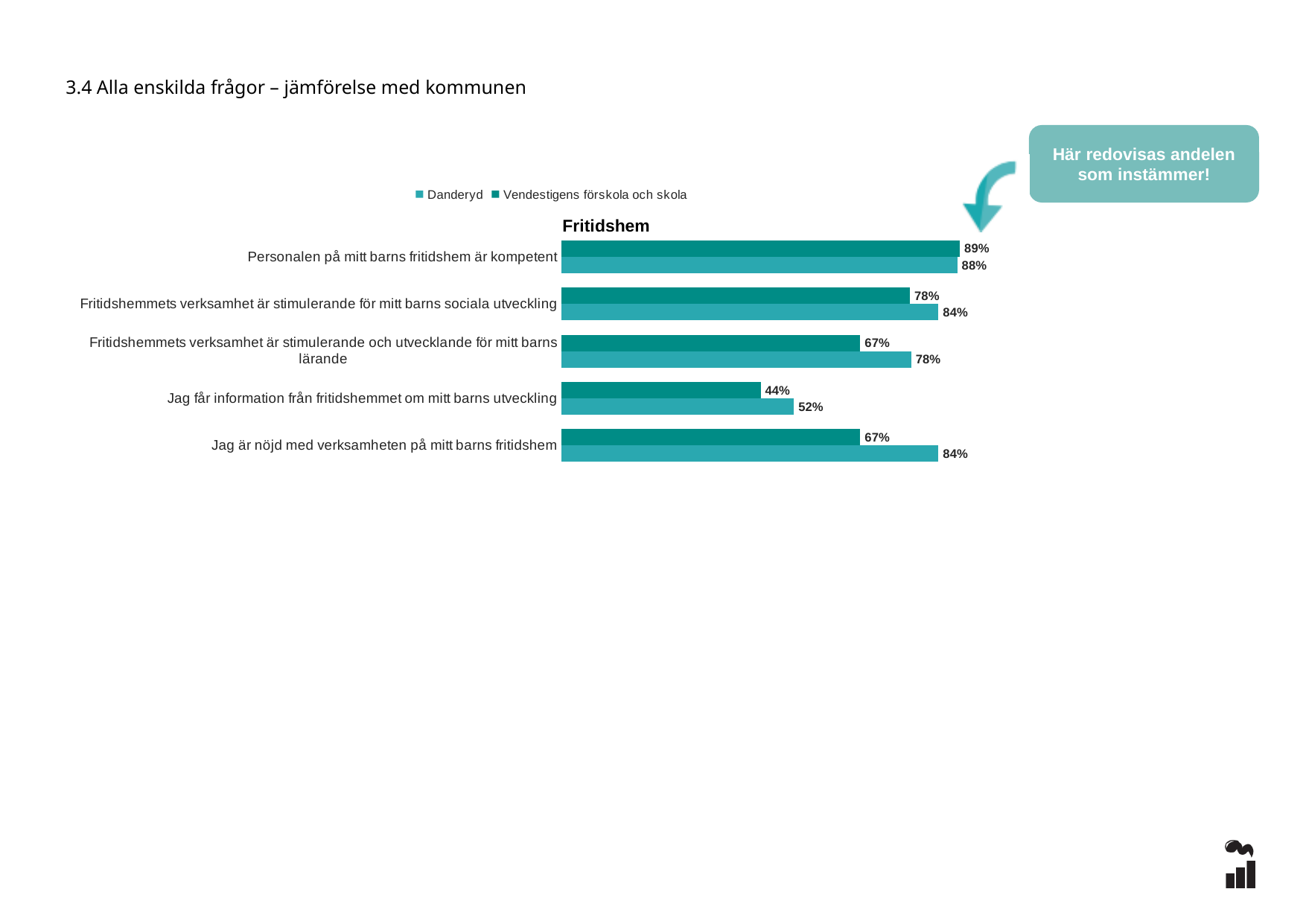
What is the value for Danderyd for 'Jag är nöjd med verksamheten på mitt barns fritidshem'? 84% What kind of chart is shown on the slide? Bar chart What is the difference between Danderyd and Vendestigens förskola och skola for 'Jag är nöjd med verksamheten på mitt barns fritidshem'? 17% How many series does the legend list? 2 Which statement has the lowest value for Vendestigens förskola och skola? Jag får information från fritidshemmet om mitt barns utveckling Which statement has the highest value for Danderyd? Personalen på mitt barns fritidshem är kompetent How many statements (categories) are shown in the chart? 5 What is the value for Vendestigens förskola och skola for 'Personalen på mitt barns fritidshem är kompetent'? 89% For 'Fritidshemmets verksamhet är stimulerande för mitt barns sociala utveckling', which is larger: Danderyd or Vendestigens förskola och skola? Danderyd What is the value for Danderyd for 'Jag får information från fritidshemmet om mitt barns utveckling'? 52% What does the callout box on the slide say? Här redovisas andelen som instämmer! What is the title of the chart? Fritidshem